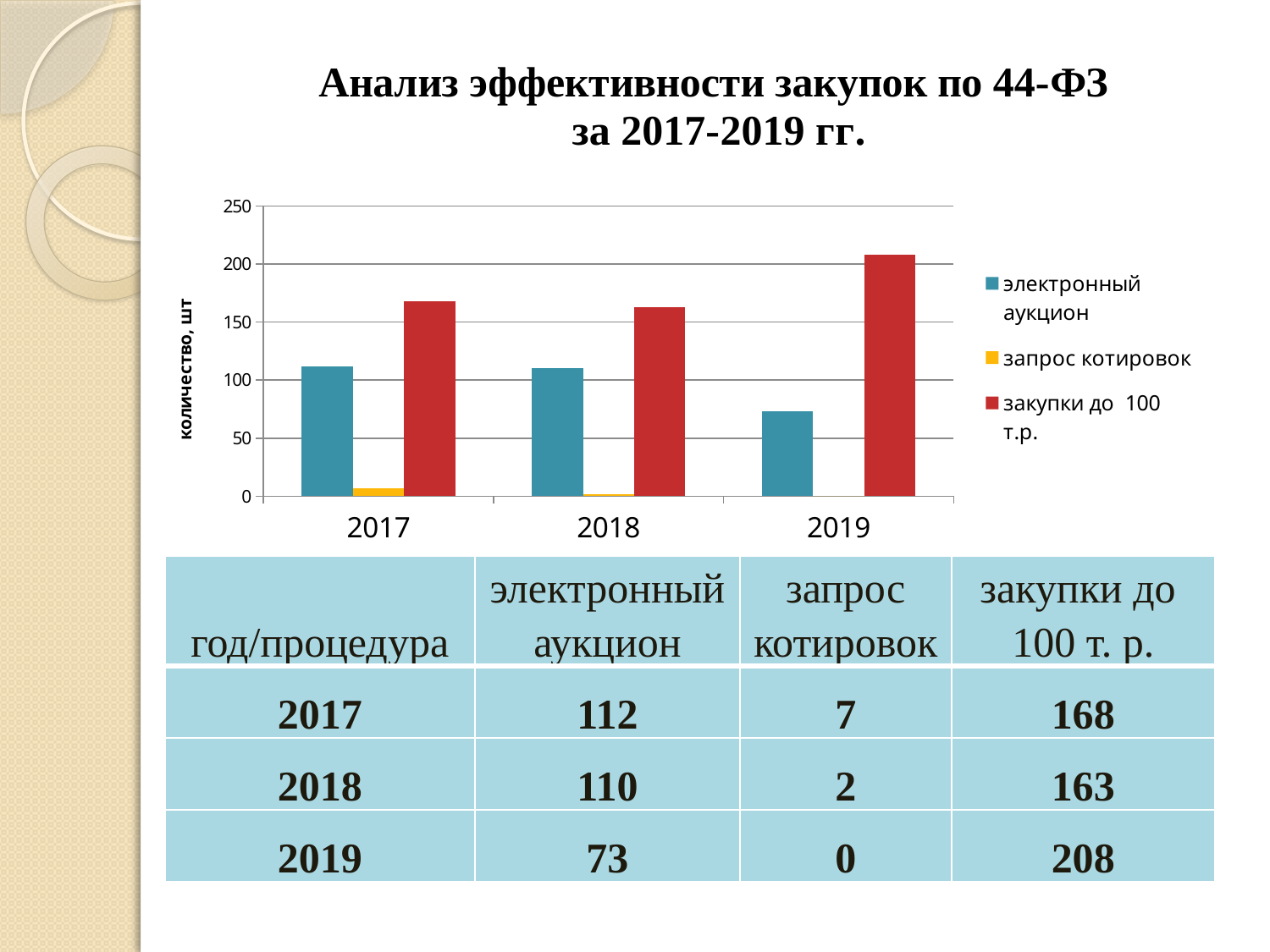
In which year is the value for закупки до 100 т.р. highest? 2019 In which year is the value for электронный аукцион lowest? 2019 What is the label of the vertical axis of the chart? количество, шт What is the value for запрос котировок in 2018? 2 What is the value for закупки до 100 т.р. in 2019? 208 How many series does the chart legend list? 3 What is the difference between закупки до 100 т.р. and электронный аукцион in 2019? 135 What is the value for электронный аукцион in 2017? 112 How many years are shown on the x axis of the chart? 3 Does the value for электронный аукцион rise or fall from 2017 to 2019? fall Which is larger in 2018: электронный аукцион or закупки до 100 т.р.? закупки до 100 т.р. What kind of chart is shown on the slide? bar chart